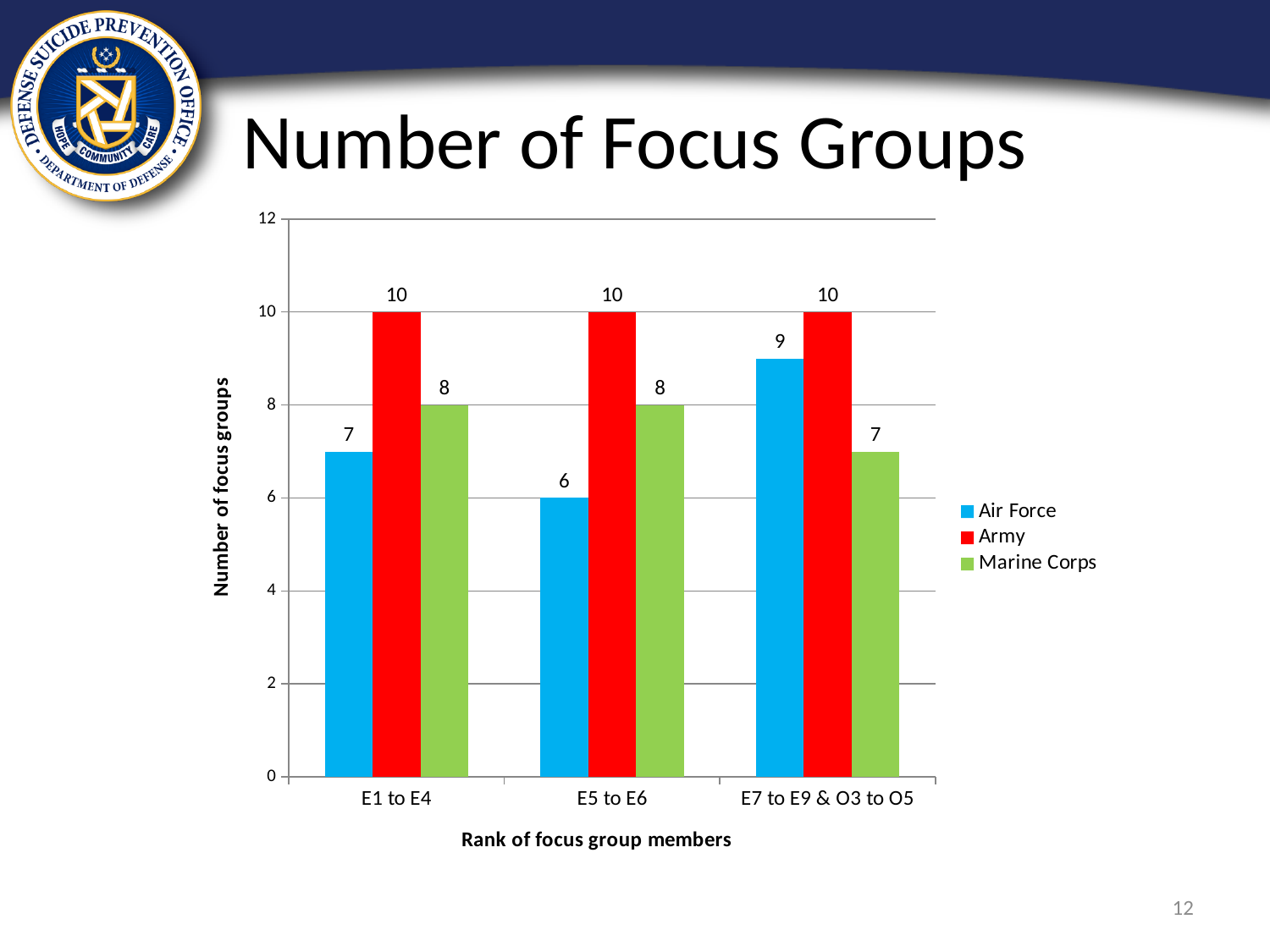
What is the label of the x axis? Rank of focus group members What kind of chart is shown on the slide? Bar chart Which rank group has the lowest number of Air Force focus groups? E5 to E6 What is the number of focus groups for Marine Corps in the E7 to E9 & O3 to O5 rank group? 7 What is the number of focus groups for Air Force in the E1 to E4 rank group? 7 Which rank group has the highest number of Air Force focus groups? E7 to E9 & O3 to O5 What is the number of focus groups for Army in the E5 to E6 rank group? 10 How many series does the legend list? 3 What is the difference between the Army and Air Force focus group counts for E5 to E6? 4 What is the title of the chart? Number of Focus Groups Which has more focus groups in the E1 to E4 rank group, Air Force or Marine Corps? Marine Corps How many rank groups are shown on the x axis? 3